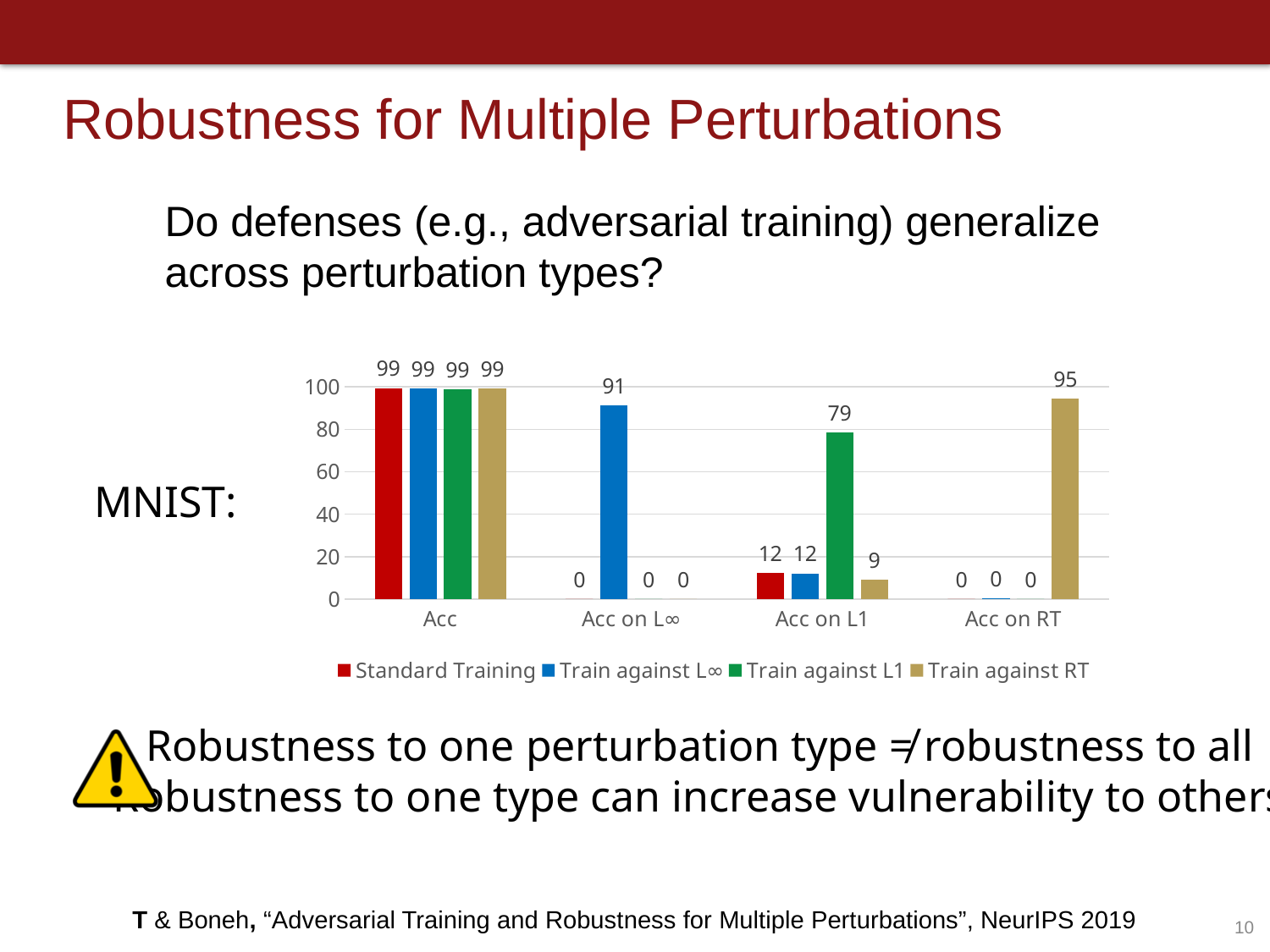
How many categories are shown on the x axis? 4 What kind of chart is shown on the slide? Bar chart What is the value for Train against RT in the Acc on L1 category? 9 What is the value for Standard Training in the Acc on L1 category? 12 Which series has the lowest value in the Acc on L1 category? Train against RT Which series has the highest value in the Acc on L1 category? Train against L1 What is the value for Train against L1 in the Acc on L1 category? 79 What is the value for Train against L∞ in the Acc on L∞ category? 91 What is the value for Train against RT in the Acc on RT category? 95 Which is larger: the Train against L∞ value in Acc on L∞ or the Train against RT value in Acc on RT? Train against RT value in Acc on RT What is the difference between the Train against L1 value and the Train against RT value in the Acc on L1 category? 70 How many series does the legend list? 4